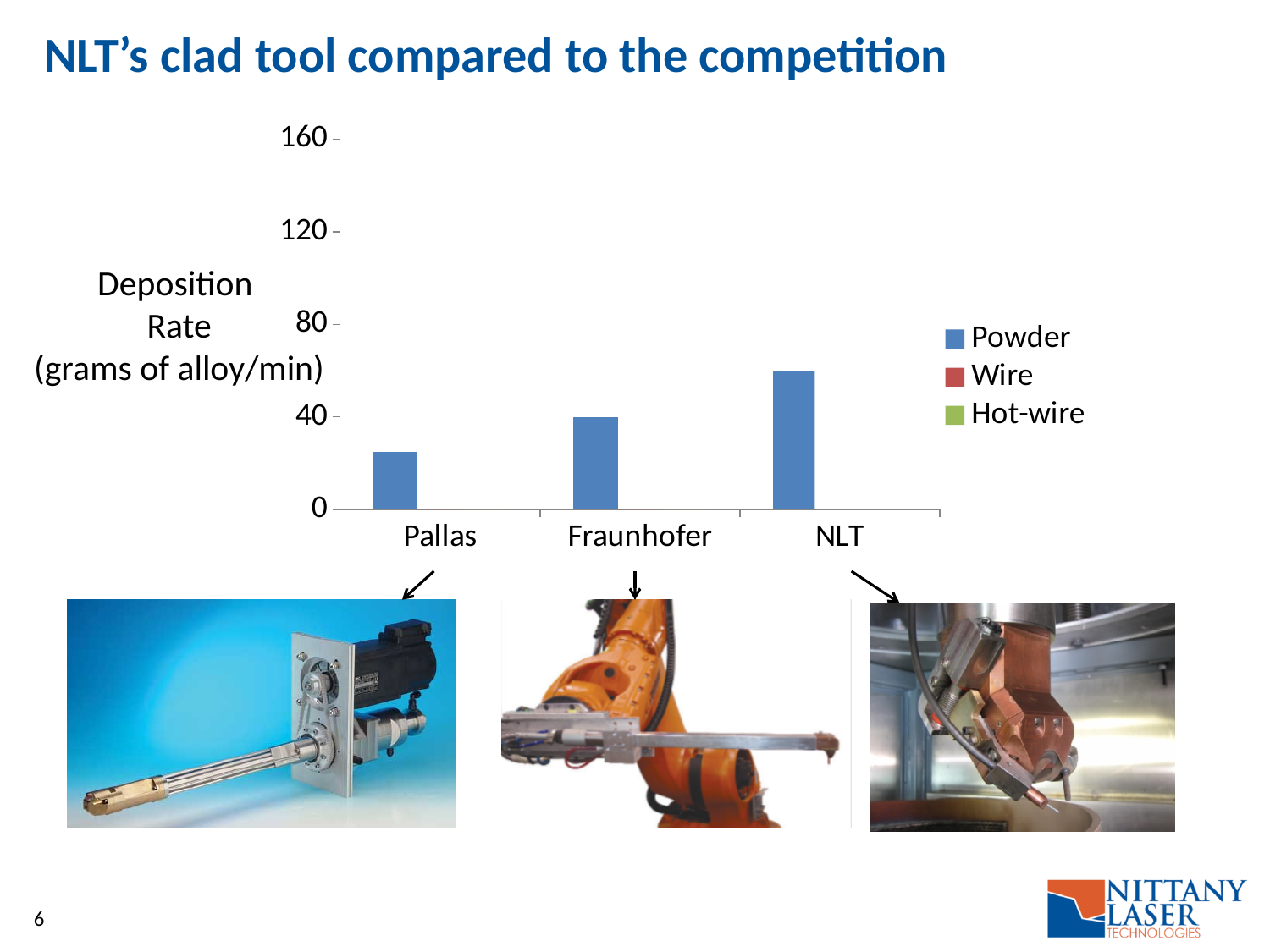
How many series does the chart's legend list? 3 What is the label on the vertical axis of the chart? Deposition Rate (grams of alloy/min) How many categories are shown on the x axis of the chart? 3 Which category has the lowest deposition rate in the chart? Pallas Do the bar values rise or fall from Pallas to NLT along the x axis? rise Is the deposition rate for NLT greater or less than 80? less Is the deposition rate for Pallas greater or less than 40? less Which category has the highest deposition rate in the chart? NLT Which legend entry is shown in blue? Powder Is the deposition rate for NLT greater or less than 40? greater What kind of chart is shown on the slide? bar chart Which has a higher deposition rate, Fraunhofer or NLT? NLT